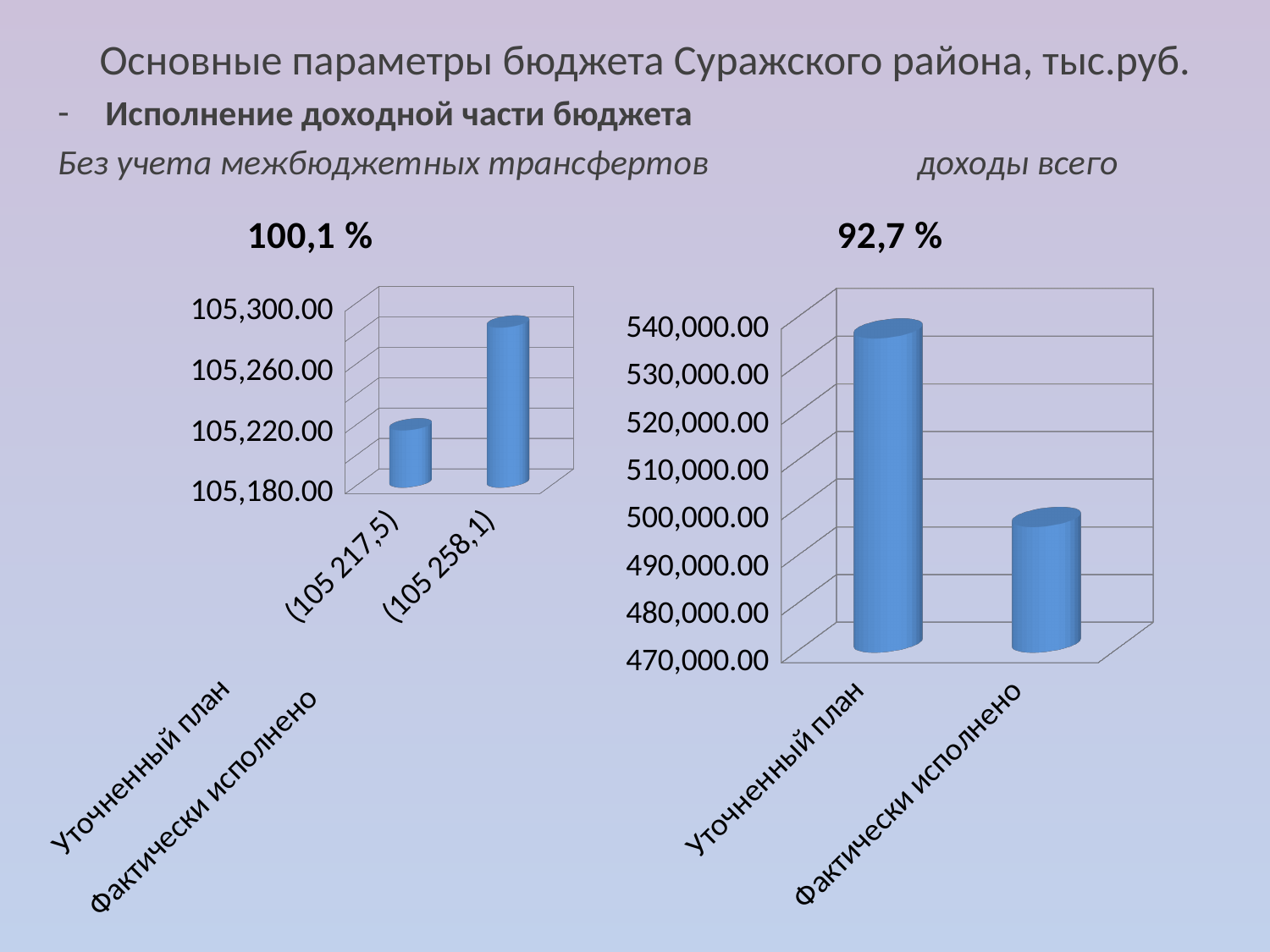
What kind of chart is the left chart (Без учета межбюджетных трансфертов)? bar chart What execution percentage is shown above the right chart (доходы всего)? 92,7 % In the right chart (доходы всего), which is larger: Уточненный план or Фактически исполнено? Уточненный план In the right chart (доходы всего), is the value for Фактически исполнено greater or less than 500,000.00? less In the left chart (Без учета межбюджетных трансфертов), what value is shown for Фактически исполнено? 105 258,1 In the right chart (доходы всего), is the value for Уточненный план greater or less than 530,000.00? greater How many categories does the right chart (доходы всего) show? 2 In the left chart (Без учета межбюджетных трансфертов), which category has the higher bar? Фактически исполнено In the left chart (Без учета межбюджетных трансфертов), what value is shown for Уточненный план? 105 217,5 What execution percentage is shown above the left chart (Без учета межбюджетных трансфертов)? 100,1 % In the right chart (доходы всего), which category has the lower bar? Фактически исполнено In the left chart (Без учета межбюджетных трансфертов), what is the difference between Фактически исполнено and Уточненный план? 40,6